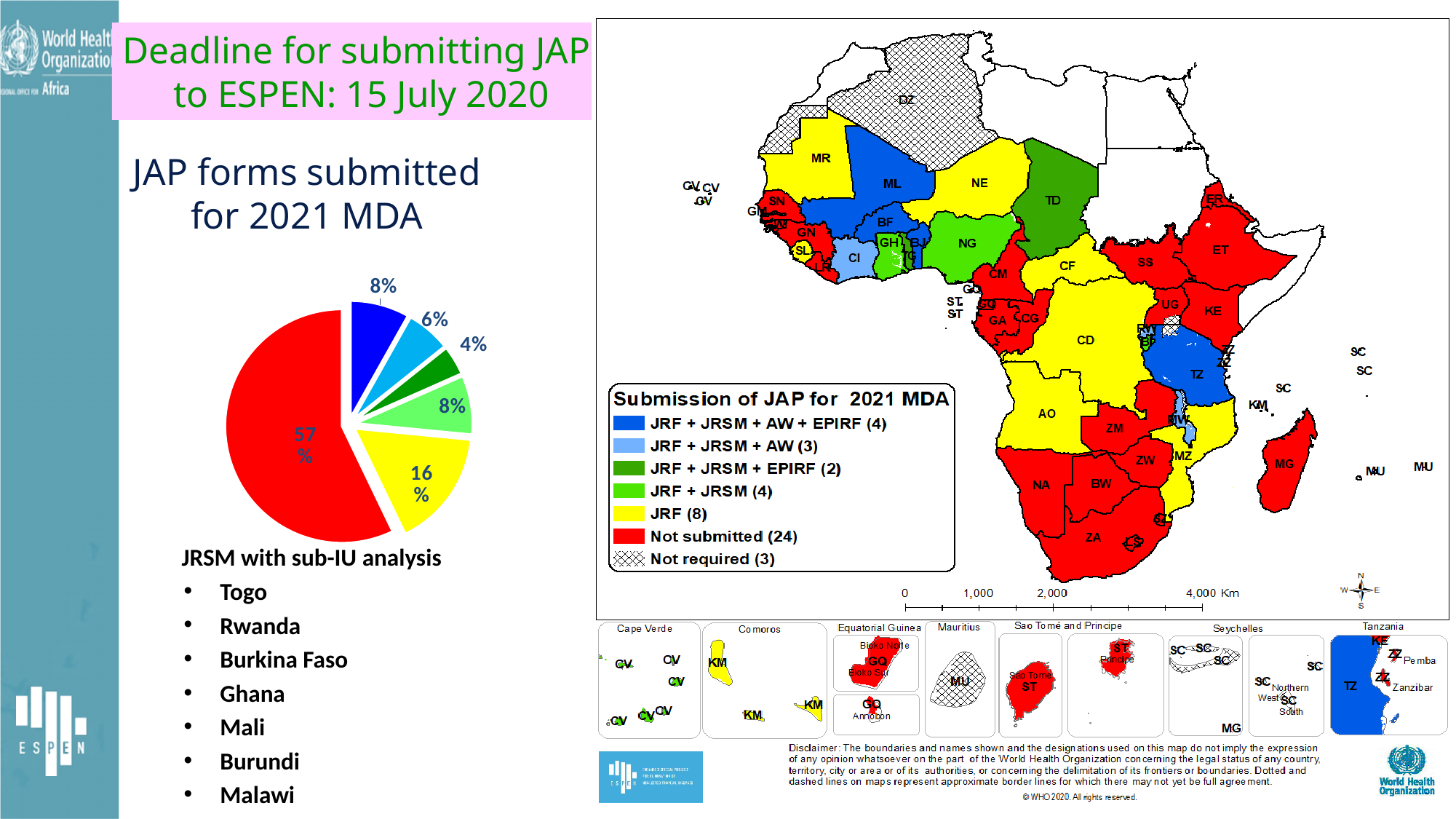
In the pie chart, what is the value of the smallest slice? 4% In the pie chart, what is the difference in percentage points between the red slice (57%) and the yellow slice (16%)? 41 In the pie chart, what percentage is shown on the yellow slice? 16% How many categories are listed in the legend of the map titled 'Submission of JAP for 2021 MDA'? 7 What is the title of the pie chart on the left of the slide? JAP forms submitted for 2021 MDA In the pie chart, what is the combined share of the two slices labelled 8%? 16% How many slices does the pie chart have? 6 In the pie chart, what percentage is shown on the red slice? 57% In the pie chart, which is larger: the yellow slice or the dark blue slice? yellow slice What type of chart is shown under the heading 'JAP forms submitted for 2021 MDA'? pie chart In the pie chart, what is the value of the largest slice? 57% In the pie chart, what percentage is shown on the dark blue slice? 8%